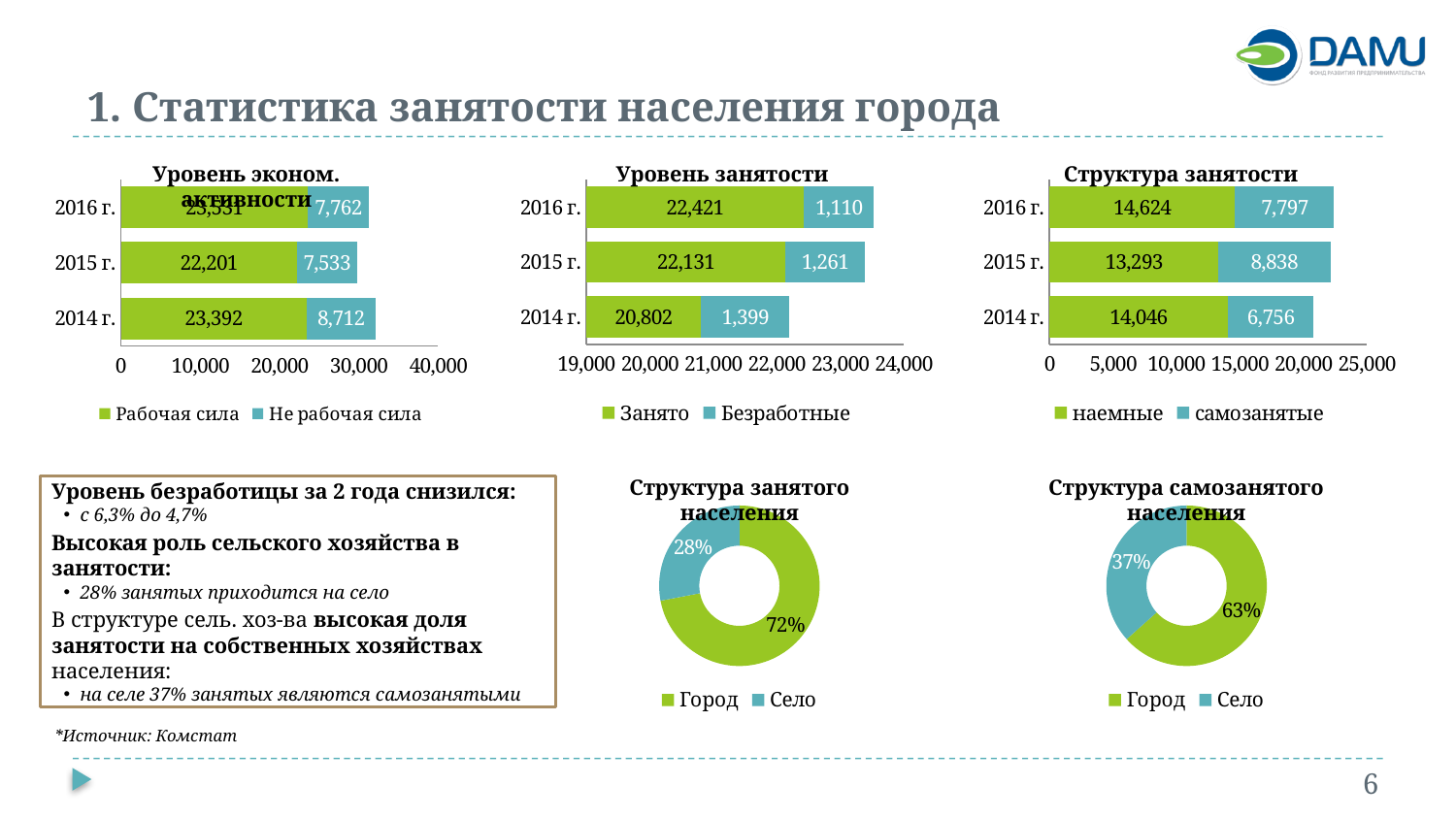
How many series does the legend of the 'Структура занятости' chart list? 2 In the 'Структура самозанятого населения' chart, what share does Город have? 63% In the 'Структура занятого населения' chart, what share does Село have? 28% In the 'Уровень занятости' chart, what is the value for Занято in 2016 г.? 22,421 In the 'Структура занятости' chart, which year has the highest value for наемные? 2016 г. In the 'Уровень занятости' chart, what is the value for Безработные in 2014 г.? 1,399 In the 'Уровень эконом. активности' chart, what is the value for Не рабочая сила in 2014 г.? 8,712 In the 'Уровень занятости' chart, what is the difference between the Занято values for 2016 г. and 2014 г.? 1,619 In the 'Уровень эконом. активности' chart, is the value for Рабочая сила in 2015 г. larger or smaller than in 2014 г.? smaller In the 'Уровень занятости' chart, which year has the lowest value for Безработные? 2016 г. In the 'Структура занятости' chart, what is the value for самозанятые in 2015 г.? 8,838 In the 'Структура занятости' chart, what is the total of the stacked bar for 2014 г.? 20,802